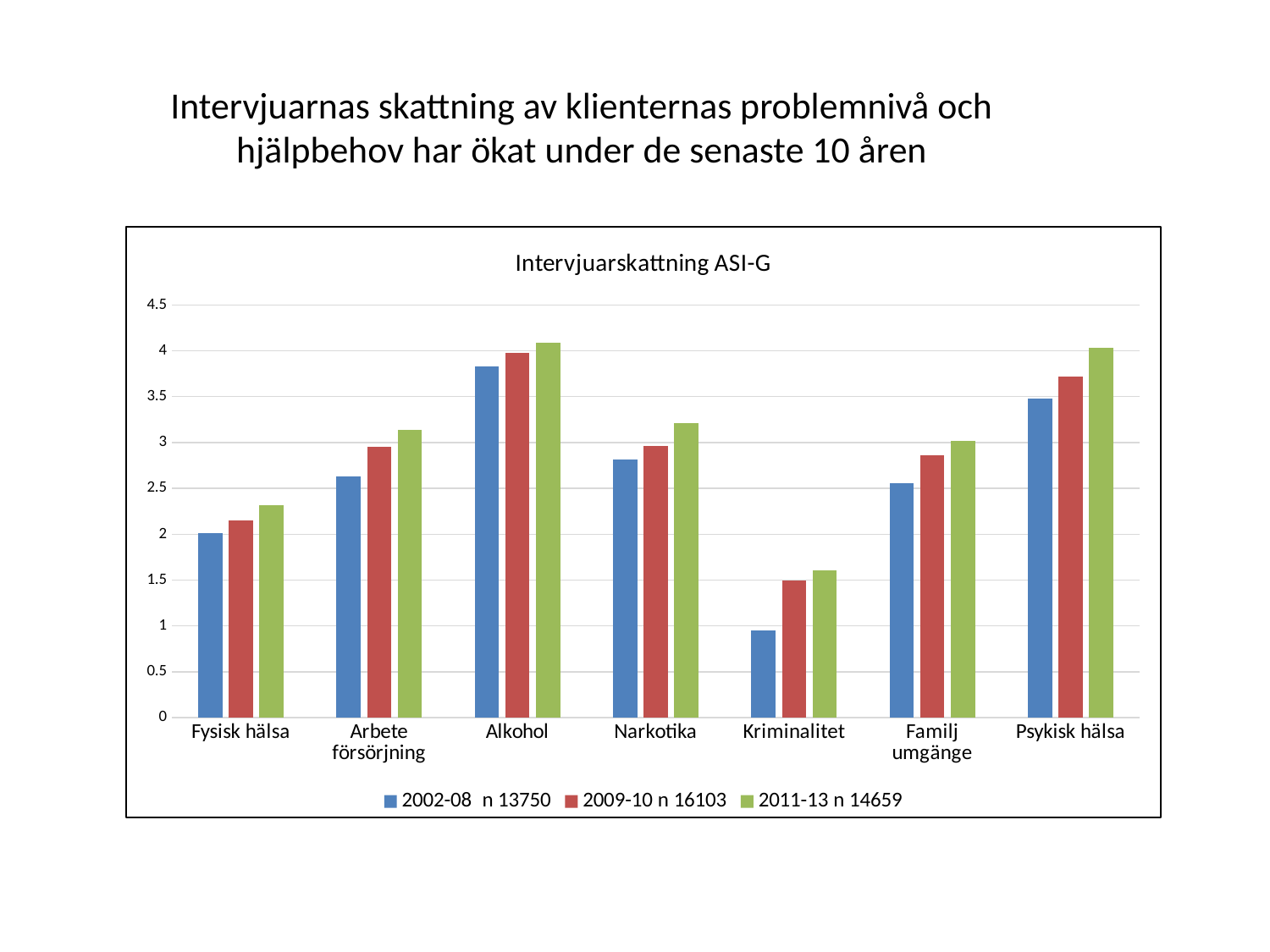
What is the title of the chart? Intervjuarskattning ASI-G How many series does the legend list? 3 Which is larger in the 2011-13 n 14659 series: Psykisk hälsa or Narkotika? Psykisk hälsa Which category has the highest value for the 2011-13 n 14659 series? Alkohol For Kriminalitet, do the values rise or fall from the 2002-08 series to the 2011-13 series? rise What kind of chart is shown on the slide? bar chart Which is larger in the 2002-08 n 13750 series: Alkohol or Psykisk hälsa? Alkohol Which category has the lowest value for the 2002-08 n 13750 series? Kriminalitet How many categories are shown on the x axis? 7 Is the value for Fysisk hälsa in the 2002-08 n 13750 series greater or less than 2.5? less Is the value for Alkohol in the 2011-13 n 14659 series greater or less than 4? greater